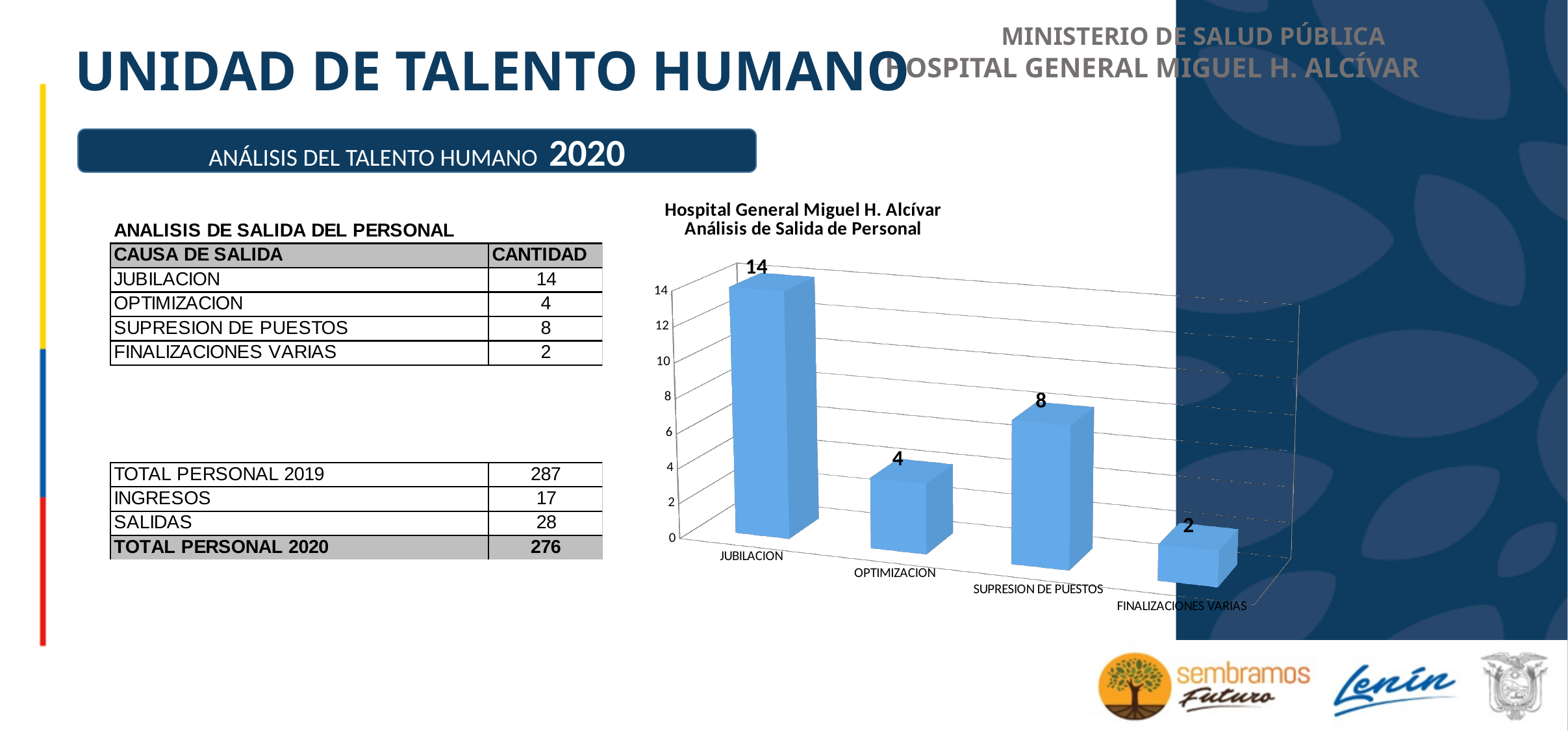
Is the value for JUBILACION greater or less than 10? greater Which category has the lowest value in the chart? FINALIZACIONES VARIAS What is the value for JUBILACION in the chart? 14 How many categories are shown in the chart? 4 What is the title of the chart? Hospital General Miguel H. Alcívar Análisis de Salida de Personal What is the difference between the values for JUBILACION and SUPRESION DE PUESTOS? 6 What is the value for SUPRESION DE PUESTOS in the chart? 8 Which is larger, the value for OPTIMIZACION or the value for SUPRESION DE PUESTOS? SUPRESION DE PUESTOS What is the value for OPTIMIZACION in the chart? 4 What is the value for FINALIZACIONES VARIAS in the chart? 2 What kind of chart is shown on the slide? bar chart Which category has the highest value in the chart? JUBILACION